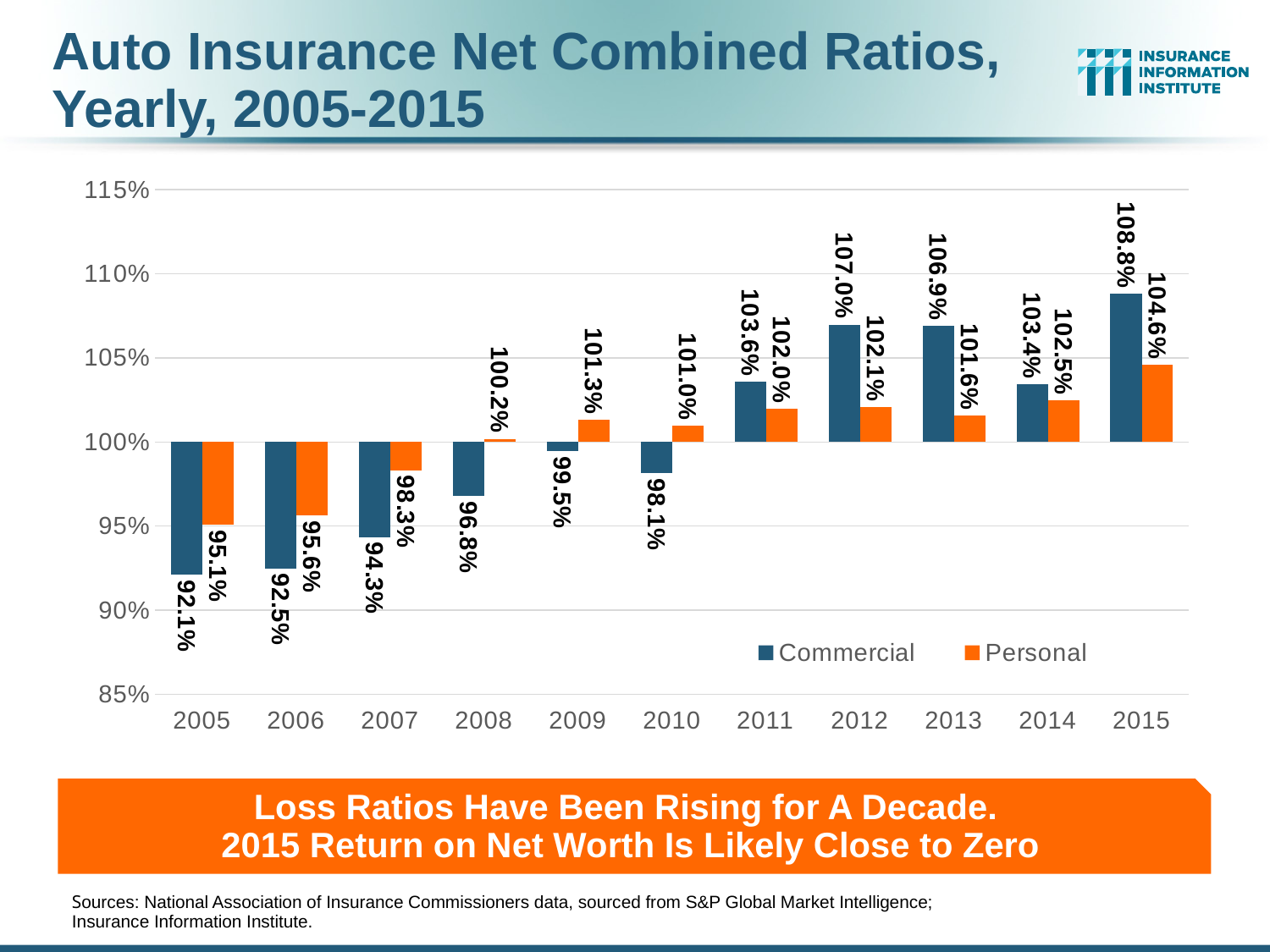
What is the Commercial net combined ratio for 2015? 108.8% What is the Personal net combined ratio for 2009? 101.3% Which year has the lowest Personal net combined ratio? 2005 Which is larger in 2008, the Commercial ratio or the Personal ratio? Personal Which is larger in 2012, the Commercial ratio or the Personal ratio? Commercial How many years are shown on the x axis? 11 Which year has the highest Commercial net combined ratio? 2015 What is the Commercial net combined ratio for 2010? 98.1% What is the difference between the Commercial and Personal ratios in 2015? 4.2% How many series does the legend list? 2 Does the Personal net combined ratio generally rise or fall from 2005 to 2015? Rise What kind of chart is shown on the slide? Bar chart